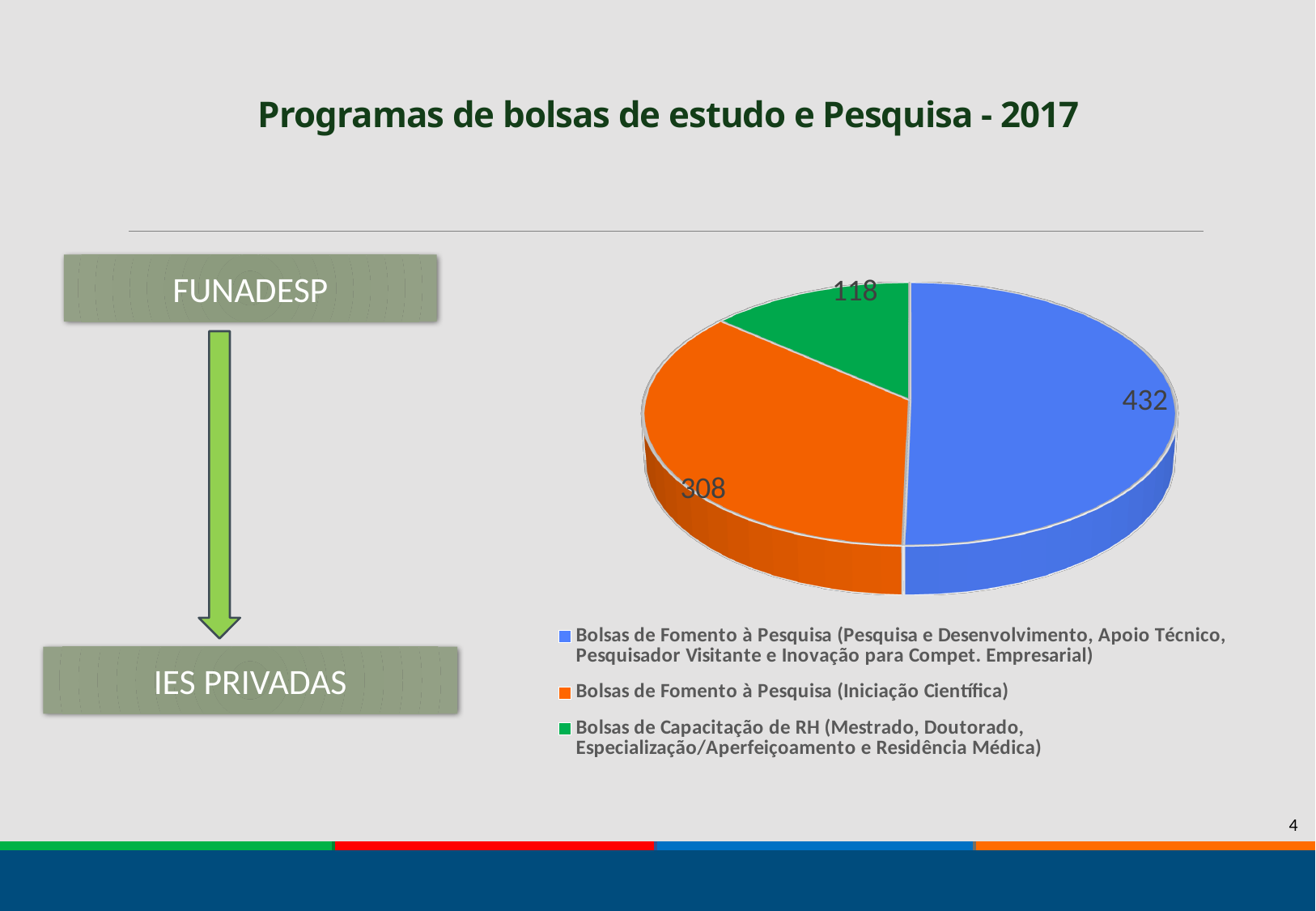
What is the difference between the value for Bolsas de Fomento à Pesquisa (Pesquisa e Desenvolvimento...) and the value for Bolsas de Fomento à Pesquisa (Iniciação Científica)? 124 What kind of chart is shown on the slide? Pie chart Which category has the smallest slice of the pie? Bolsas de Capacitação de RH (Mestrado, Doutorado, Especialização/Aperfeiçoamento e Residência Médica) Which is larger: the value for Bolsas de Fomento à Pesquisa (Iniciação Científica) or the value for Bolsas de Capacitação de RH? Bolsas de Fomento à Pesquisa (Iniciação Científica) What is the value for Bolsas de Fomento à Pesquisa (Iniciação Científica)? 308 How many slices does the pie chart have? 3 What colour is the slice for Bolsas de Capacitação de RH? Green What is the value for Bolsas de Fomento à Pesquisa (Pesquisa e Desenvolvimento, Apoio Técnico, Pesquisador Visitante e Inovação para Compet. Empresarial)? 432 Which category has the largest slice of the pie? Bolsas de Fomento à Pesquisa (Pesquisa e Desenvolvimento, Apoio Técnico, Pesquisador Visitante e Inovação para Compet. Empresarial) What is the value for Bolsas de Capacitação de RH (Mestrado, Doutorado, Especialização/Aperfeiçoamento e Residência Médica)? 118 What is the difference between the value for Bolsas de Fomento à Pesquisa (Iniciação Científica) and the value for Bolsas de Capacitação de RH? 190 What is the total of all the values shown in the pie chart? 858